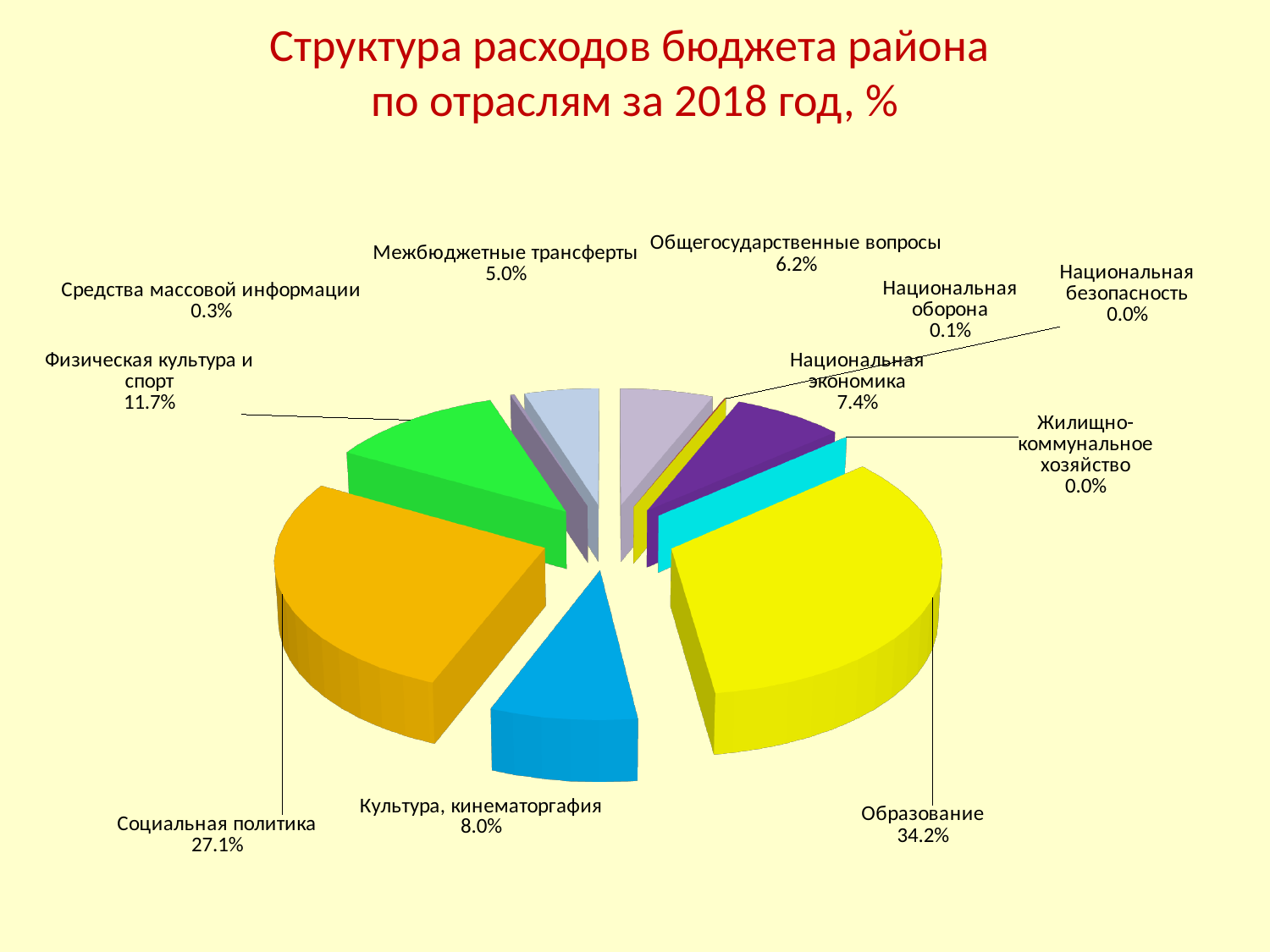
What share of the district budget expenditure goes to Образование? 34.2% Which category has the largest share of the budget expenditure? Образование What percentage is shown for Физическая культура и спорт? 11.7% What kind of chart is shown on the slide? Pie chart What is the value shown for Социальная политика? 27.1% What percentage is shown for Межбюджетные трансферты? 5.0% What is the difference between the shares of Образование and Социальная политика? 7.1% What is the title of the chart on the slide? Структура расходов бюджета района по отраслям за 2018 год, % What is the value shown for Национальная оборона? 0.1% What is the value for Национальная экономика? 7.4% Which is larger, the share for Культура, кинематография or the share for Общегосударственные вопросы? Культура, кинематография How many categories are shown in the pie chart? 11